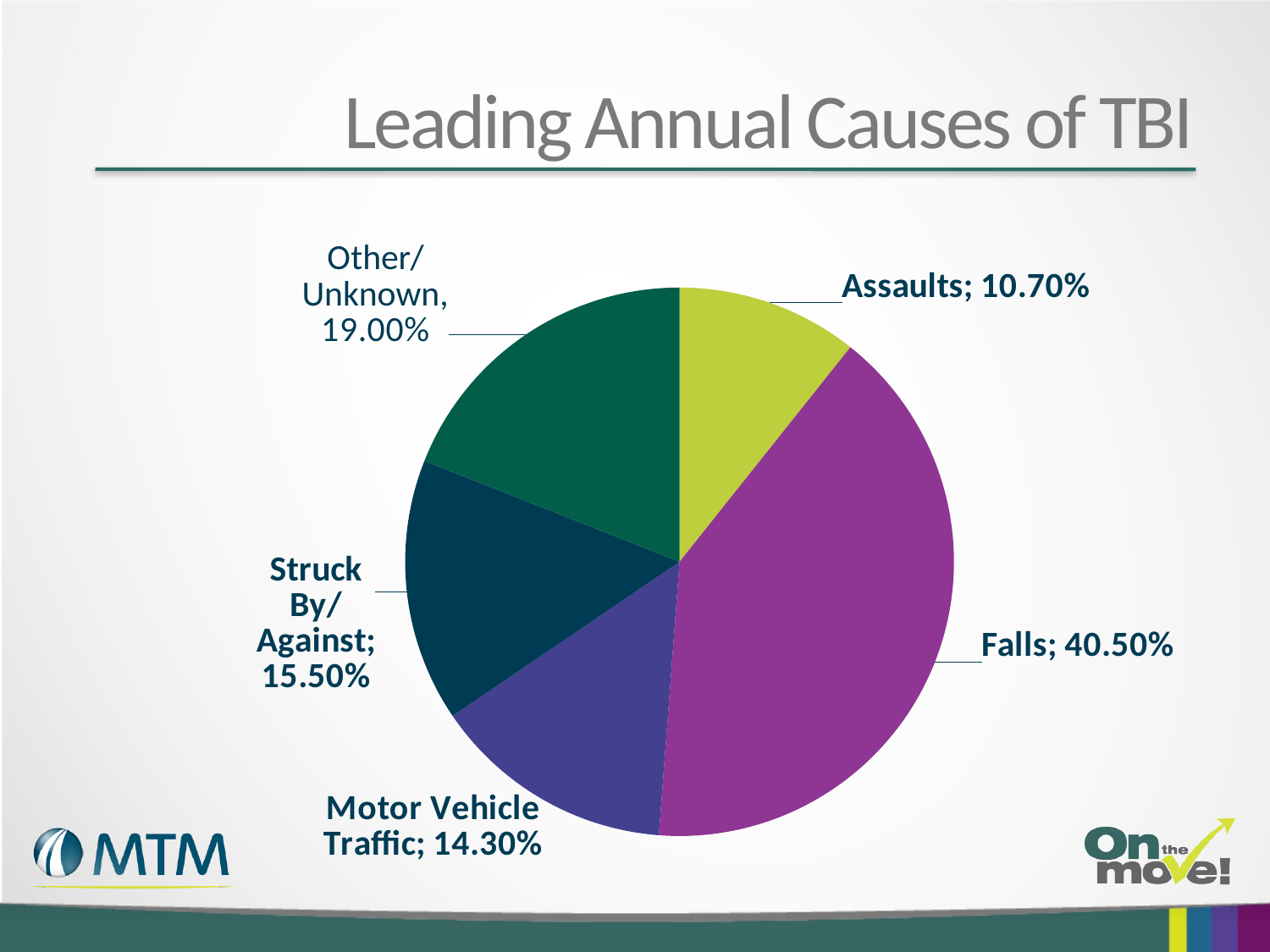
How many slices does the pie chart have? 5 Which is larger, the share for Struck By/Against or the share for Motor Vehicle Traffic? Struck By/Against What percentage is shown for Motor Vehicle Traffic? 14.30% What is the difference between the Falls share and the Other/Unknown share? 21.50% Which cause has the smallest share of the pie? Assaults What percentage of TBI causes is attributed to Falls? 40.50% What type of chart is shown on the slide? pie chart What percentage is shown for Assaults? 10.70% What percentage is shown for Other/Unknown? 19.00% What is the title of the chart? Leading Annual Causes of TBI Which cause has the largest share of the pie? Falls What percentage is shown for Struck By/Against? 15.50%